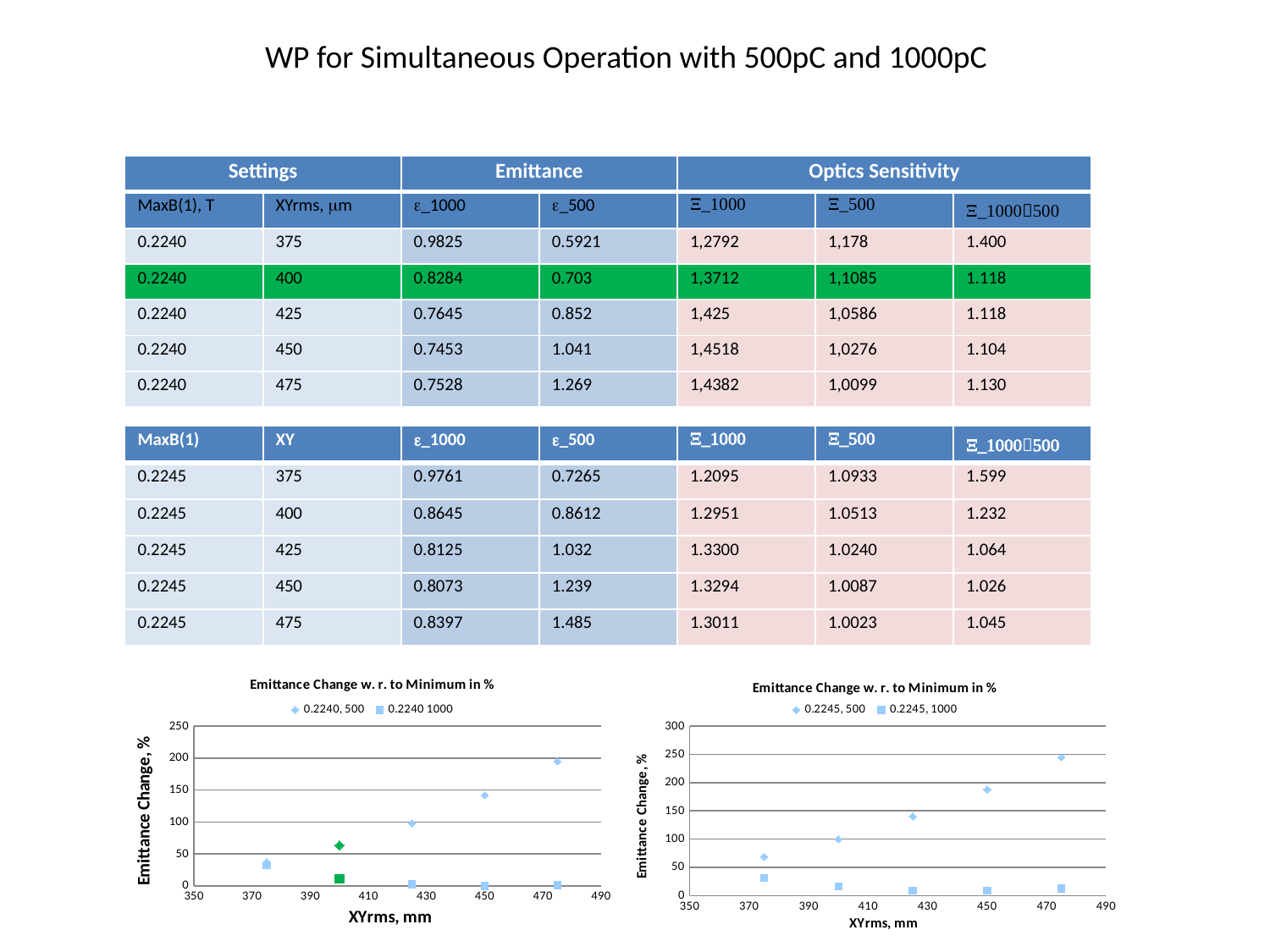
In the right chart, is the value of the '0.2245, 500' series at XYrms 475 greater or less than 200? greater In the left chart, is the value of the '0.2240, 500' series at XYrms 475 greater or less than 150? greater How many series does the legend of the right chart (0.2245) list? 2 In the right chart, is the value of the '0.2245, 500' series at XYrms 375 greater or less than 100? less In the right chart, do the values of the '0.2245, 500' series rise or fall as XYrms increases from 375 to 475? rise In the left chart, do the values of the '0.2240, 500' series rise or fall as XYrms increases from 375 to 475? rise In the right chart, how many data points are plotted for the '0.2245, 1000' series? 5 In the left chart, how many data points are plotted for the '0.2240, 500' series? 5 What kind of chart is the left chart titled 'Emittance Change w. r. to Minimum in %'? scatter chart In the left chart, at XYrms 475, which series has the larger value: '0.2240, 500' or '0.2240 1000'? 0.2240, 500 In the left chart, at which XYrms value does the '0.2240, 500' series reach its highest point? 475 What is the label of the y axis on the right chart? Emittance Change, %